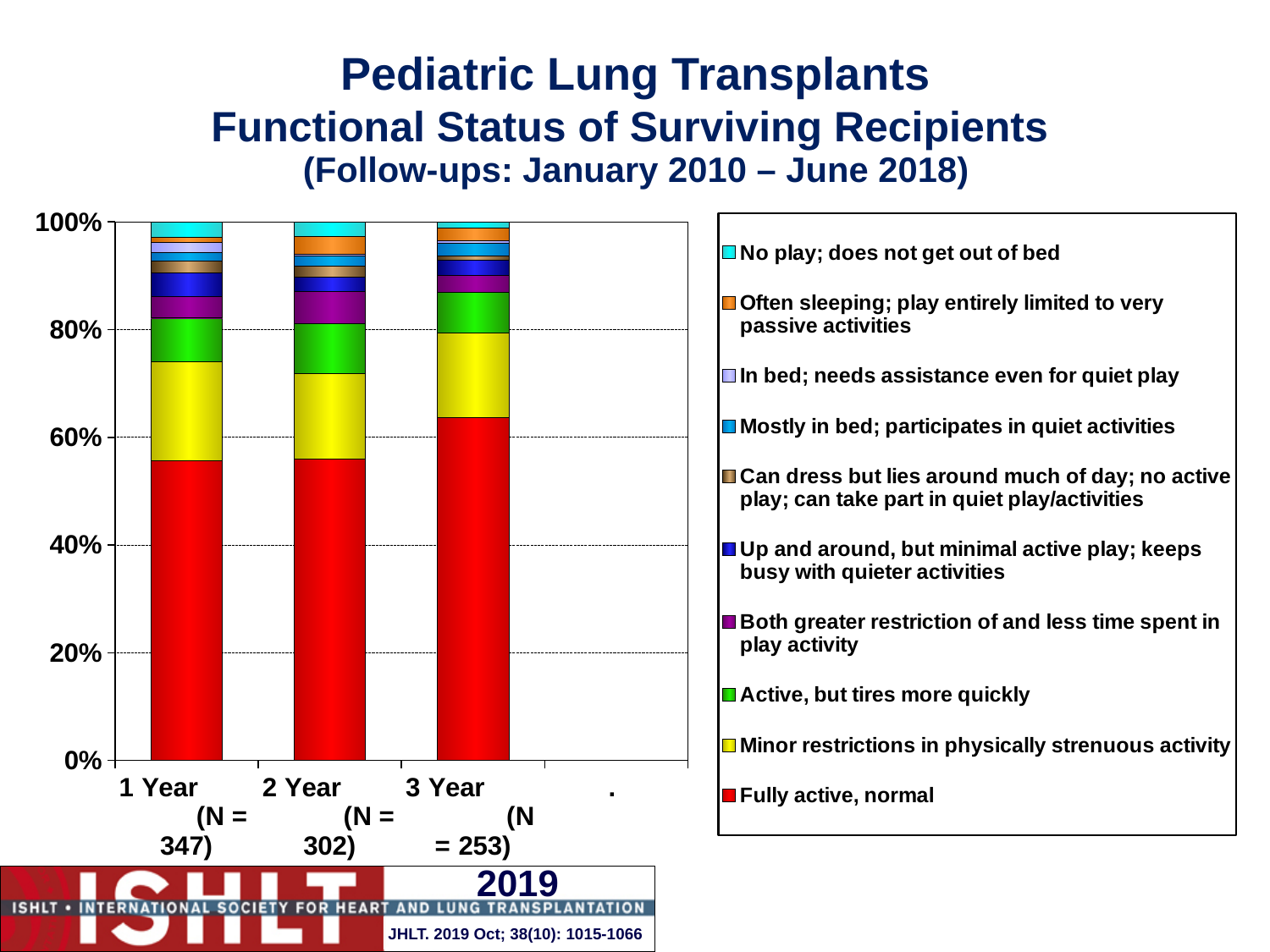
What does each stacked bar total? 100% Which follow-up time point has the largest 'Fully active, normal' share? 3 Year How many follow-up time points (categories) are plotted on the x axis? 3 How many functional status categories does the legend list? 10 Is the 'Fully active, normal' share larger at 1 Year or at 3 Year? 3 Year Is the 'Fully active, normal' share at 1 Year greater or less than 60%? less Is the 'Fully active, normal' share at 3 Year greater or less than 60%? greater Is the 'Fully active, normal' share at 2 Year greater or less than 60%? less What kind of chart is shown on the slide? Stacked bar chart What is the N for the 3 Year follow-up? 253 What is the N for the 1 Year follow-up? 347 Which colour represents 'Fully active, normal' in the legend? Red